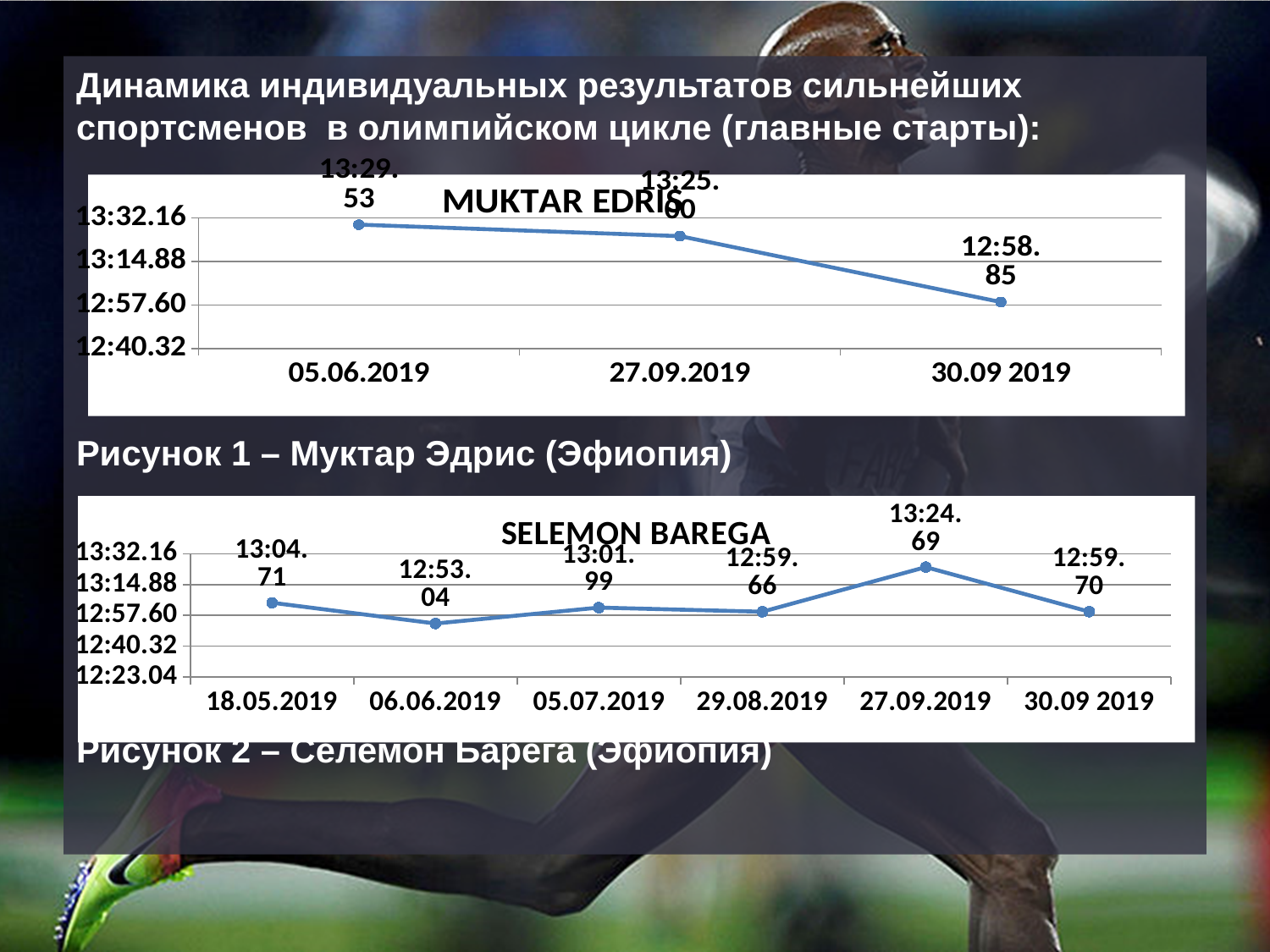
In the SELEMON BAREGA chart, which date has the lowest value? 06.06.2019 In the MUKTAR EDRIS chart, what is the value for 05.06.2019? 13:29.53 In the SELEMON BAREGA chart, how many data points are plotted? 6 In the MUKTAR EDRIS chart, how many data points are plotted? 3 In the MUKTAR EDRIS chart, what is the value for 30.09 2019? 12:58.85 In the SELEMON BAREGA chart, which is larger: the value for 18.05.2019 or the value for 05.07.2019? 18.05.2019 In the SELEMON BAREGA chart, what is the value for 27.09.2019? 13:24.69 In the SELEMON BAREGA chart, what is the value for 06.06.2019? 12:53.04 In the MUKTAR EDRIS chart, do the values rise or fall from left to right along the x axis? fall What kind of chart is the MUKTAR EDRIS chart? line chart In the SELEMON BAREGA chart, which date has the highest value? 27.09.2019 In the SELEMON BAREGA chart, what is the value for 18.05.2019? 13:04.71